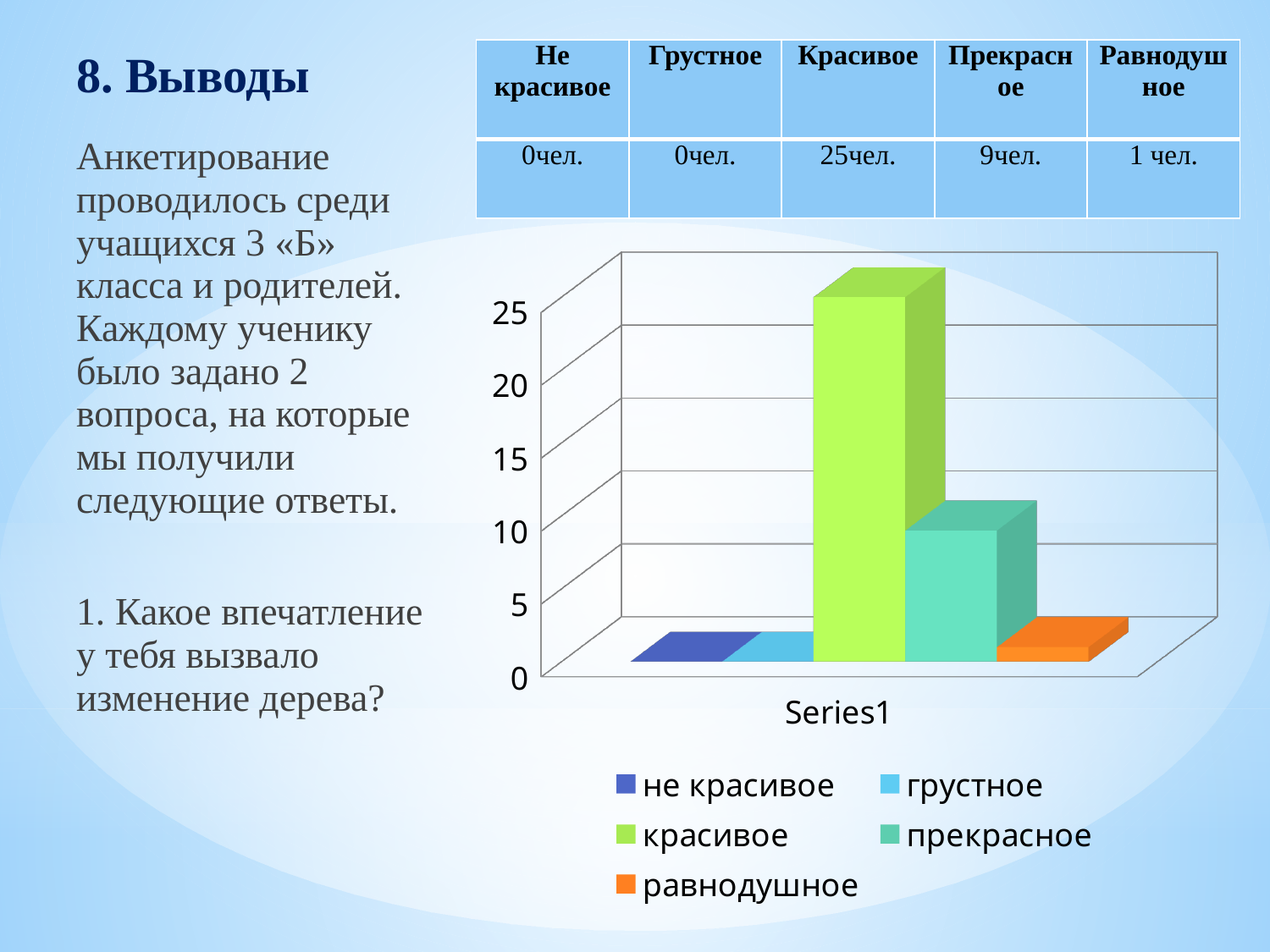
Is the value for красивое greater or less than 20? greater Using the values in the table, what is the difference between Красивое and Прекрасное? 16 Which is larger, the value for красивое or the value for прекрасное? красивое Which is larger, the value for прекрасное or the value for равнодушное? прекрасное Is the value for равнодушное greater or less than 5? less How many series does the chart legend list? 5 Is the value for прекрасное greater or less than 10? less According to the table above the chart, how many people answered Красивое? 25чел. What kind of chart is shown on the slide? bar chart Which category has the tallest bar in the chart? красивое What label is shown on the x axis under the bars? Series1 According to the table above the chart, how many people answered Прекрасное? 9чел.